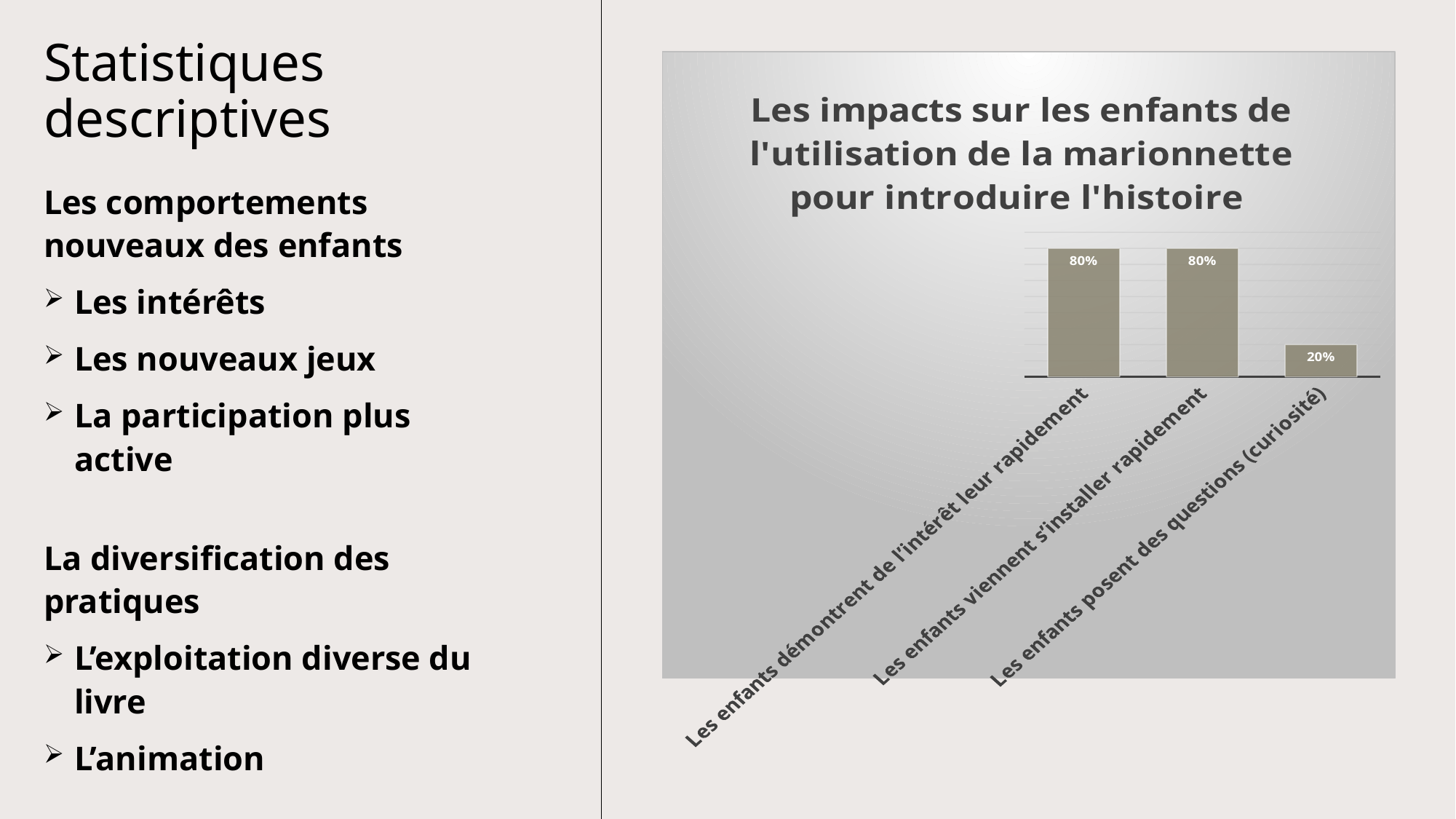
What kind of chart is shown on the slide? Bar chart Which is larger: the value for 'Les enfants démontrent de l'intérêt leur rapidement' or the value for 'Les enfants posent des questions (curiosité)'? Les enfants démontrent de l'intérêt leur rapidement What is the title of the chart? Les impacts sur les enfants de l'utilisation de la marionnette pour introduire l'histoire What is the value for 'Les enfants viennent s'installer rapidement'? 80% How many categories have a value of 80%? 2 What is the value for 'Les enfants démontrent de l'intérêt leur rapidement'? 80% What is the value for 'Les enfants posent des questions (curiosité)'? 20% What is the difference between the value for 'Les enfants viennent s'installer rapidement' and the value for 'Les enfants posent des questions (curiosité)'? 60% Which category has the lowest value? Les enfants posent des questions (curiosité) Do the two categories 'Les enfants démontrent de l'intérêt leur rapidement' and 'Les enfants viennent s'installer rapidement' have the same value? Yes How many categories are shown in the chart? 3